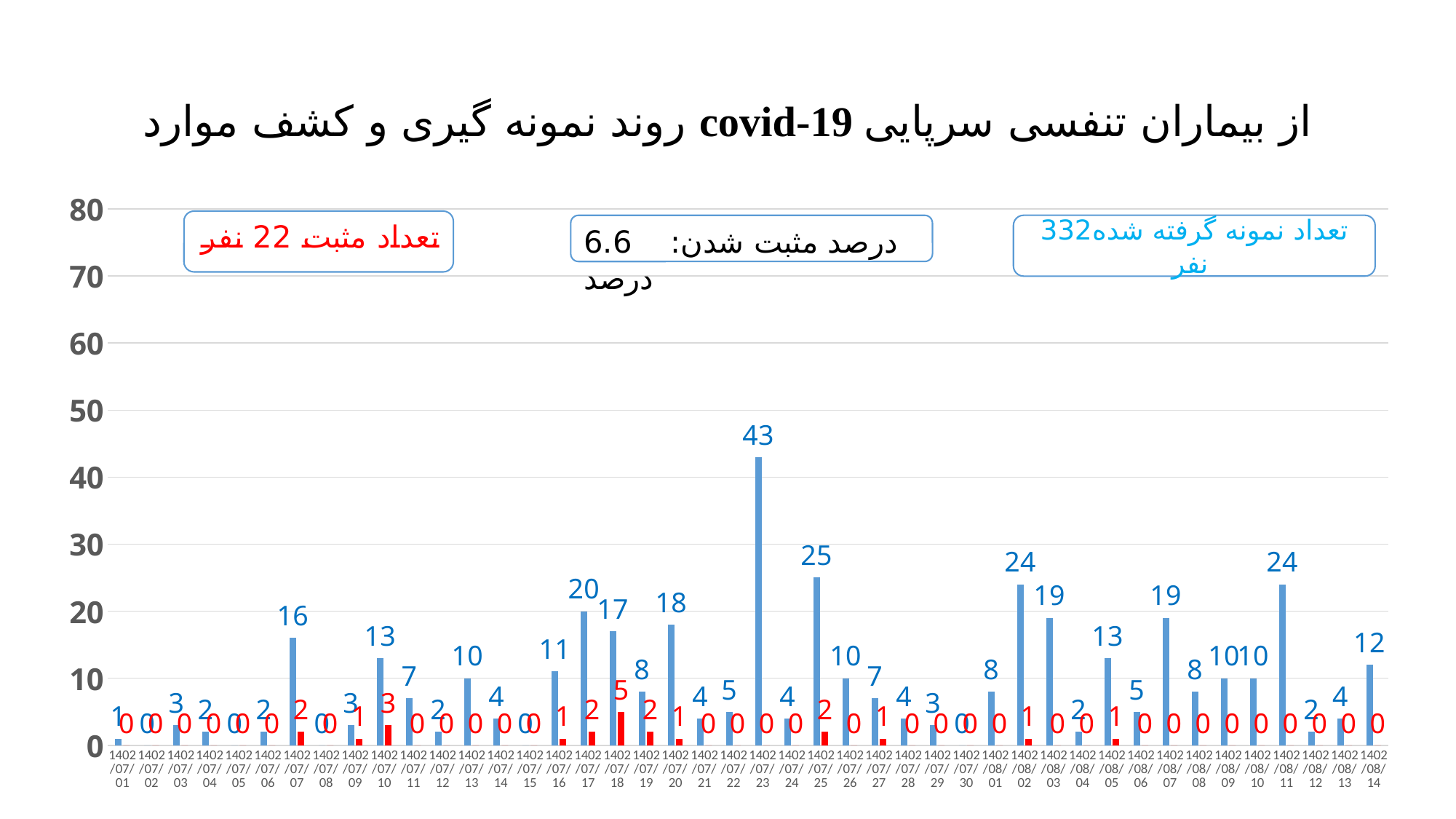
How many dates are shown on the x axis? 44 What is the value of the blue bar for 1402/07/23? 43 What is the total number of samples taken shown in the blue text box on the slide? 332 What is the value of the red bar for 1402/07/10? 3 What is the value of the blue bar for 1402/08/02? 24 Which date has the highest red bar? 1402/07/18 What is the difference between the blue bar values for 1402/07/23 and 1402/07/25? 18 What is the value of the red bar for 1402/07/18? 5 Which date has the highest blue bar? 1402/07/23 What type of chart is shown on the slide? bar chart What is the value of the blue bar for 1402/07/10? 13 Which is larger, the blue bar for 1402/07/17 or the blue bar for 1402/07/20? 1402/07/17